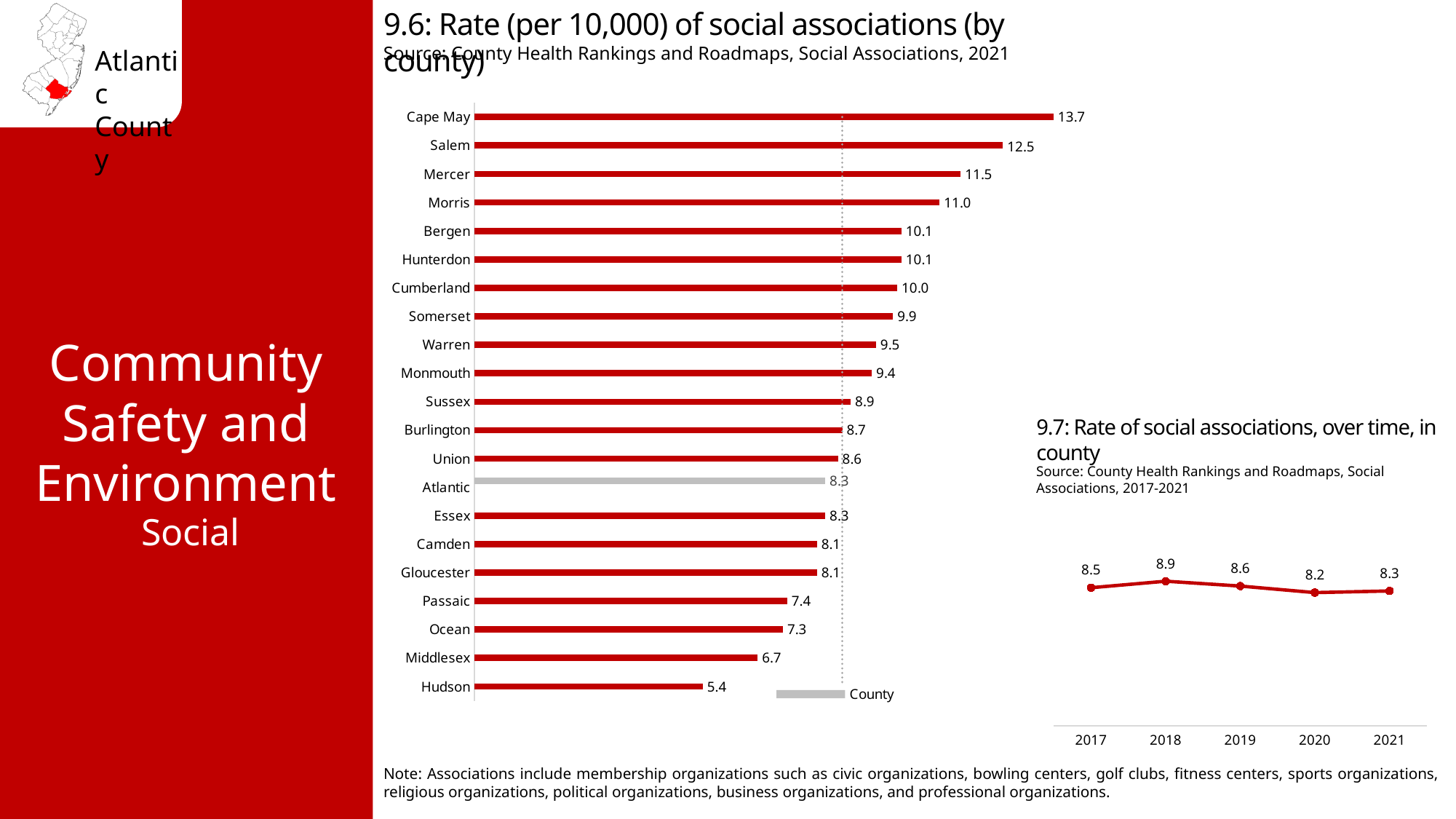
In chart 9.7 (rate of social associations over time), what is the value for 2018? 8.9 What kind of chart is chart 9.6 (rate of social associations by county)? Bar chart In chart 9.6 (rate of social associations by county), which county has the highest rate? Cape May In chart 9.6 (rate of social associations by county), how many counties are plotted? 21 In chart 9.6 (rate of social associations by county), what is the value for Cape May? 13.7 In chart 9.7 (rate of social associations over time), which year has the lowest value? 2020 In chart 9.6 (rate of social associations by county), what is the difference between Cape May and Hudson? 8.3 In chart 9.7 (rate of social associations over time), what is the difference between the 2018 and 2020 values? 0.7 In chart 9.6 (rate of social associations by county), what is the value for Atlantic? 8.3 In chart 9.6 (rate of social associations by county), which is larger, the value for Salem or the value for Mercer? Salem In chart 9.6 (rate of social associations by county), which county's bar is shown in grey instead of red? Atlantic In chart 9.6 (rate of social associations by county), which county has the lowest rate? Hudson